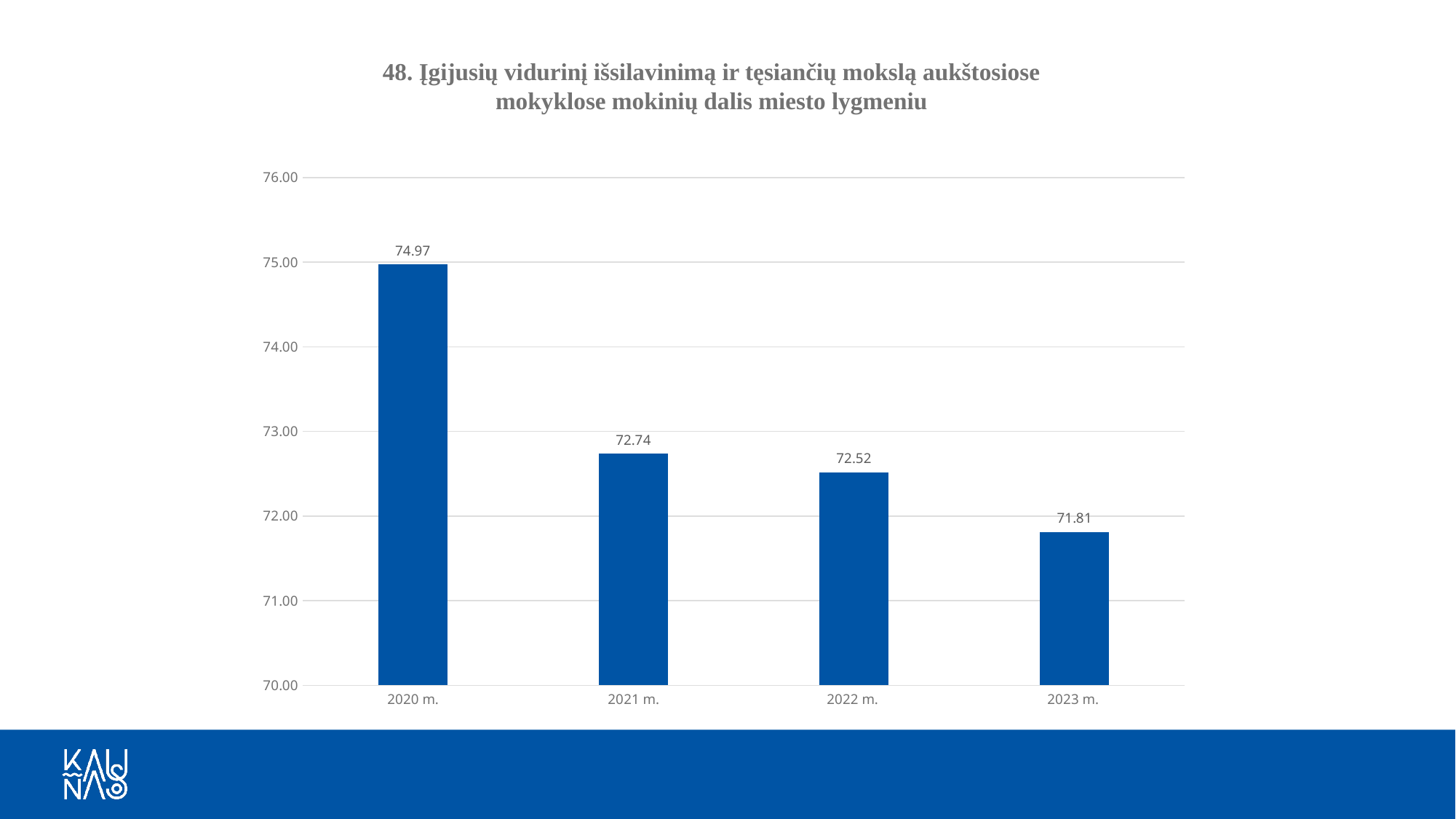
What is the value for 2023 m.? 71.81 What is the difference between the values for 2021 m. and 2022 m.? 0.22 How many years are shown on the chart? 4 Which is larger, the value for 2021 m. or the value for 2023 m.? 2021 m. What is the value for 2021 m.? 72.74 Which year has the lowest value? 2023 m. Is the value for 2022 m. greater or less than 73.00? less What is the value for 2022 m.? 72.52 What is the difference between the values for 2020 m. and 2023 m.? 3.16 Which year has the highest value? 2020 m. Do the values rise or fall from 2020 m. to 2023 m.? fall What is the value for 2020 m.? 74.97